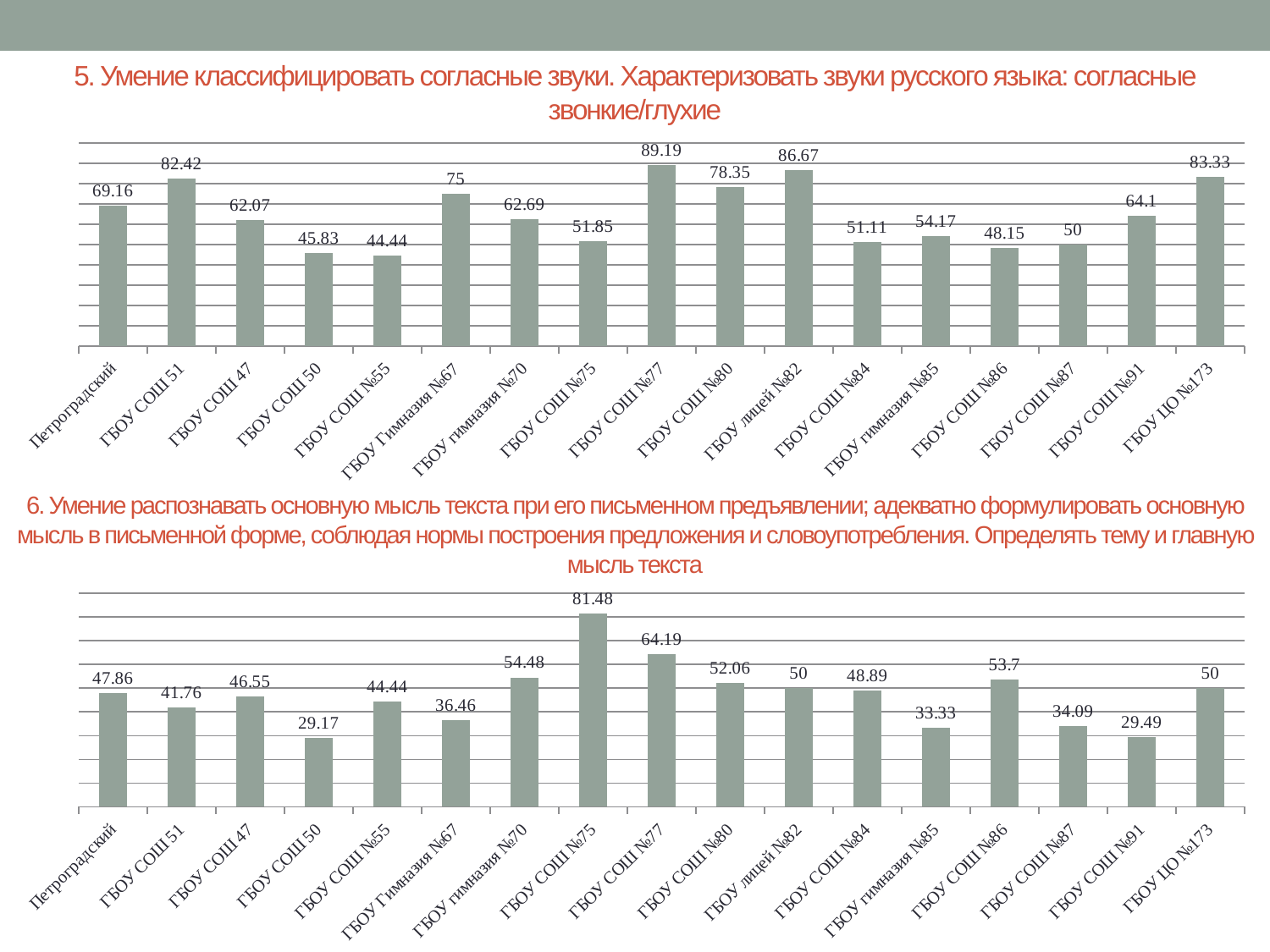
In the bottom chart, what is the value for ГБОУ СОШ №75? 81.48 In the bottom chart, which is larger: the value for ГБОУ гимназия №85 or ГБОУ СОШ №87? ГБОУ СОШ №87 In the top chart, what is the difference between the values for ГБОУ СОШ 51 and ГБОУ СОШ 47? 20.35 What type of chart is the bottom chart? Bar chart In the bottom chart, what is the difference between the values for ГБОУ СОШ №77 and ГБОУ СОШ №80? 12.13 In the top chart, which category has the lowest value? ГБОУ СОШ №55 In the top chart, what is the value for ГБОУ СОШ №77? 89.19 In the bottom chart, which category has the lowest value? ГБОУ СОШ 50 In the top chart, which category has the highest value? ГБОУ СОШ №77 How many categories are shown in the top chart? 17 In the top chart, which is larger: the value for ГБОУ лицей №82 or ГБОУ ЦО №173? ГБОУ лицей №82 In the top chart, what is the value for Петроградский? 69.16